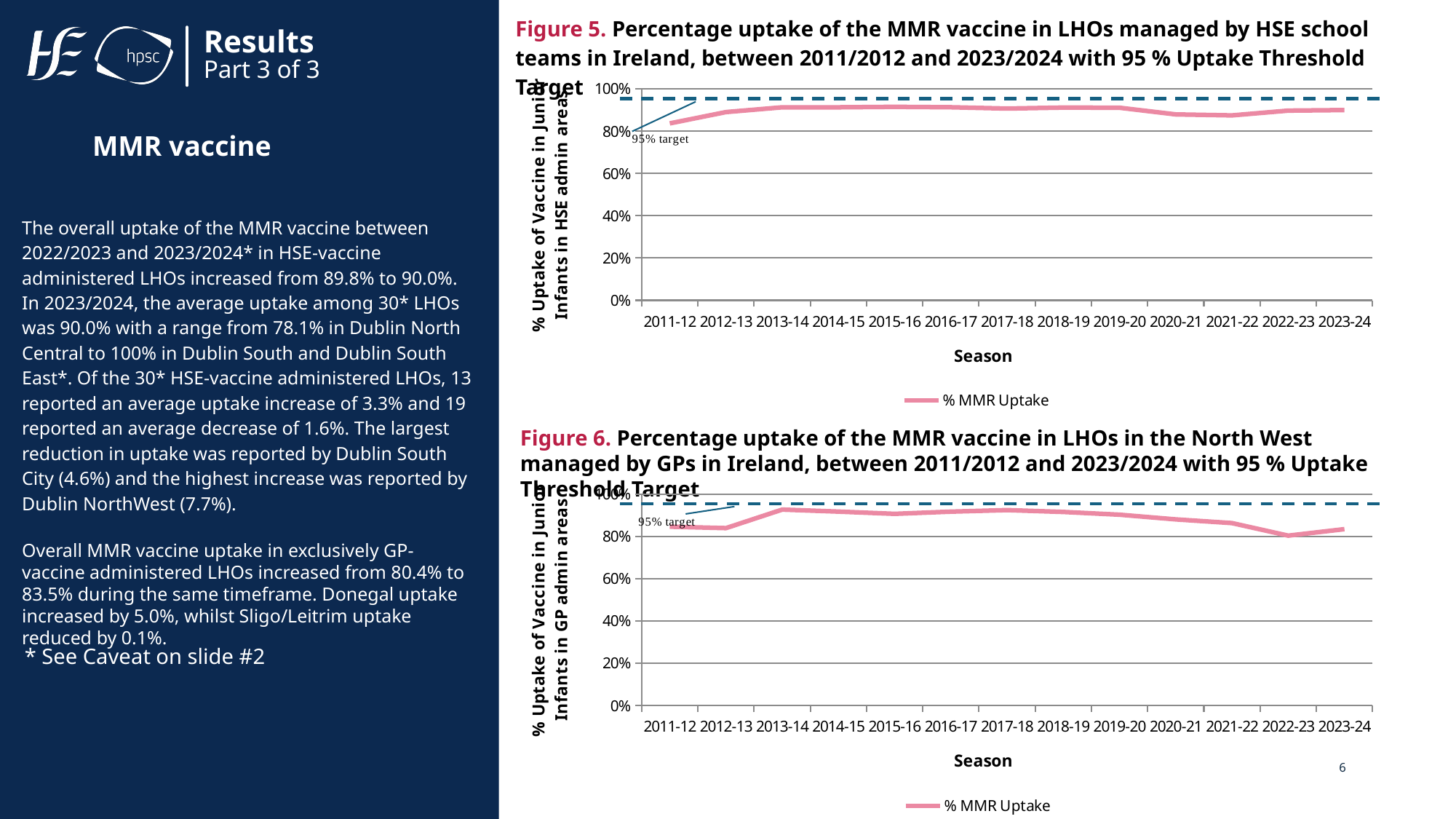
In Figure 5, is the % MMR Uptake higher in 2013-14 or in 2011-12? 2013-14 What kind of chart is Figure 5? line chart What uptake threshold does the dashed line in Figure 5 represent? 95% target In Figure 6, which season has the lowest % MMR Uptake? 2022-23 In Figure 6, is the value for 2013-14 greater or less than 80%? greater In Figure 6, does the % MMR Uptake rise or fall from 2017-18 to 2022-23? fall How many series does the legend of Figure 6 list? 1 In Figure 5, which season has the lowest % MMR Uptake? 2011-12 In Figure 6, is the % MMR Uptake higher in 2013-14 or in 2012-13? 2013-14 In Figure 5, is the value for 2011-12 greater or less than 80%? greater How many seasons are shown on the x axis of Figure 5? 13 In Figure 5, does the % MMR Uptake rise or fall from 2011-12 to 2013-14? rise